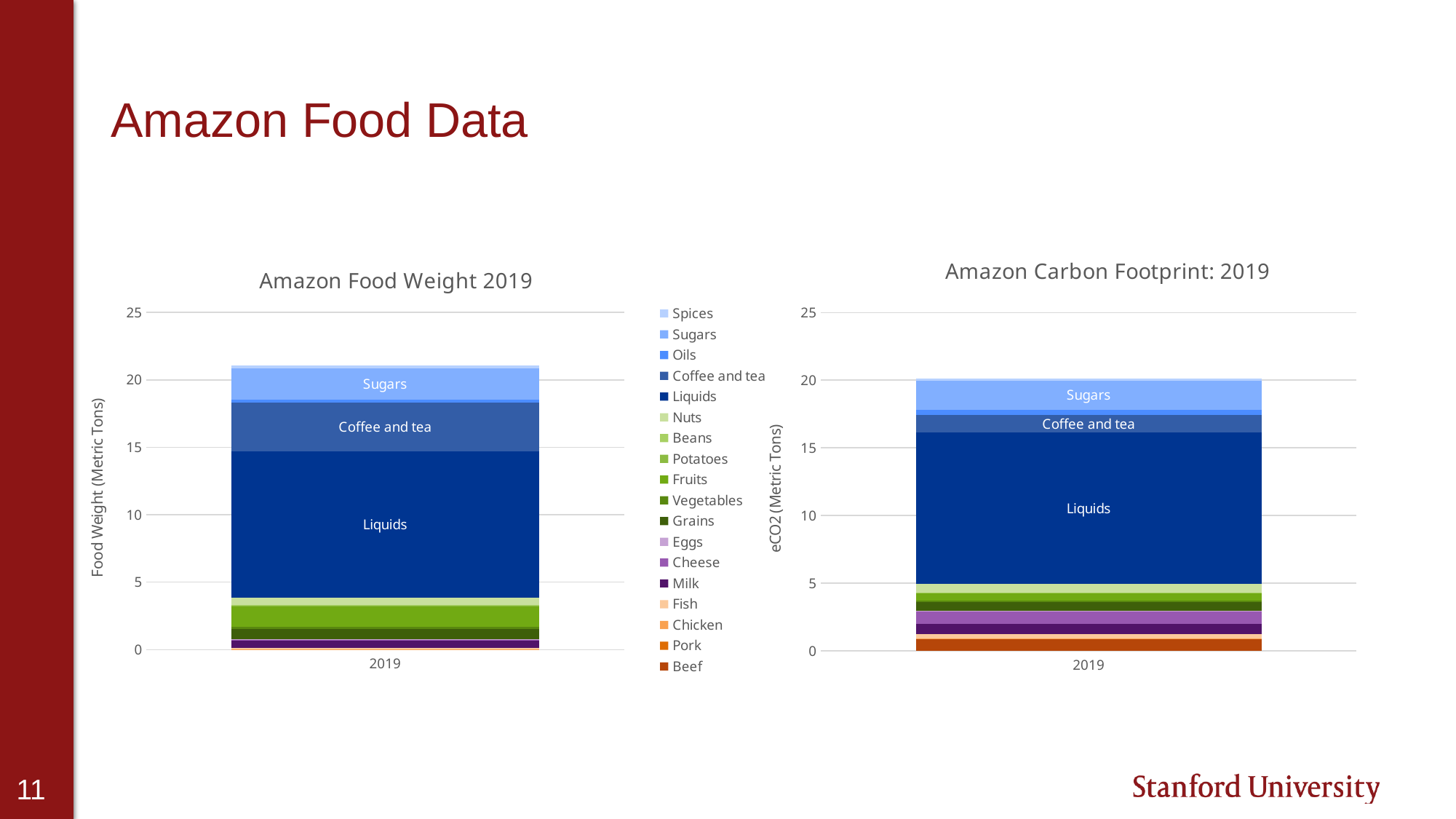
What kind of chart is the 'Amazon Food Weight 2019' chart? Stacked bar chart In the 'Amazon Carbon Footprint: 2019' chart, is the Liquids segment greater or less than 10? greater In the 'Amazon Carbon Footprint: 2019' chart, which series has the largest segment? Liquids In the 'Amazon Food Weight 2019' chart, is the Liquids segment greater or less than 10 metric tons? greater In the 'Amazon Food Weight 2019' chart, is the total height of the 2019 bar greater or less than 20? greater What is the y-axis label of the 'Amazon Carbon Footprint: 2019' chart? eCO2 (Metric Tons) In the 'Amazon Food Weight 2019' chart, which series has the largest segment? Liquids In the 'Amazon Food Weight 2019' chart, which segment is larger, Liquids or Sugars? Liquids How many series does the legend list? 18 How many categories are shown on the x axis of the 'Amazon Carbon Footprint: 2019' chart? 1 What is the title of the chart on the left of the slide? Amazon Food Weight 2019